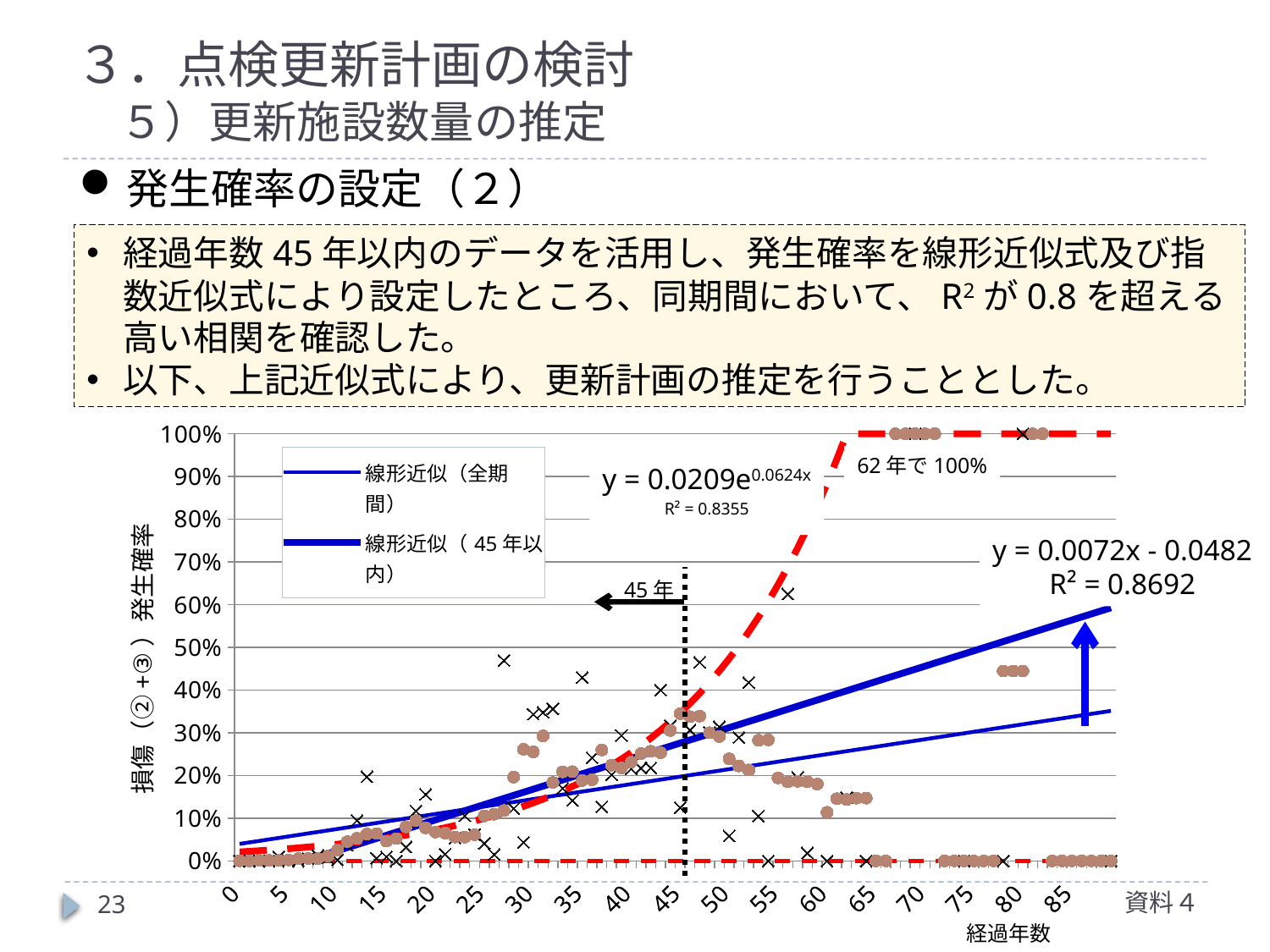
Which of the two R² values printed on the chart is larger, 0.8355 or 0.8692? 0.8692 How many series does the chart's legend list? 2 What is the label of the chart's vertical axis? 損傷（②+③）発生確率 What exponential approximation equation is printed on the chart? y = 0.0209e^0.0624x What is the R² value printed for the linear approximation y = 0.0072x - 0.0482? R² = 0.8692 What is the difference between the two R² values printed on the chart (0.8692 and 0.8355)? 0.0337 According to the annotation on the chart, at how many years does the red dashed curve reach 100%? 62年 What kind of chart is shown on the slide? line chart What is the R² value printed for the exponential approximation y = 0.0209e^0.0624x? R² = 0.8355 What is the label of the chart's horizontal axis? 経過年数 What linear approximation equation is printed on the chart? y = 0.0072x - 0.0482 Does the thick blue line labelled 線形近似（45年以内） rise or fall as 経過年数 increases? rise